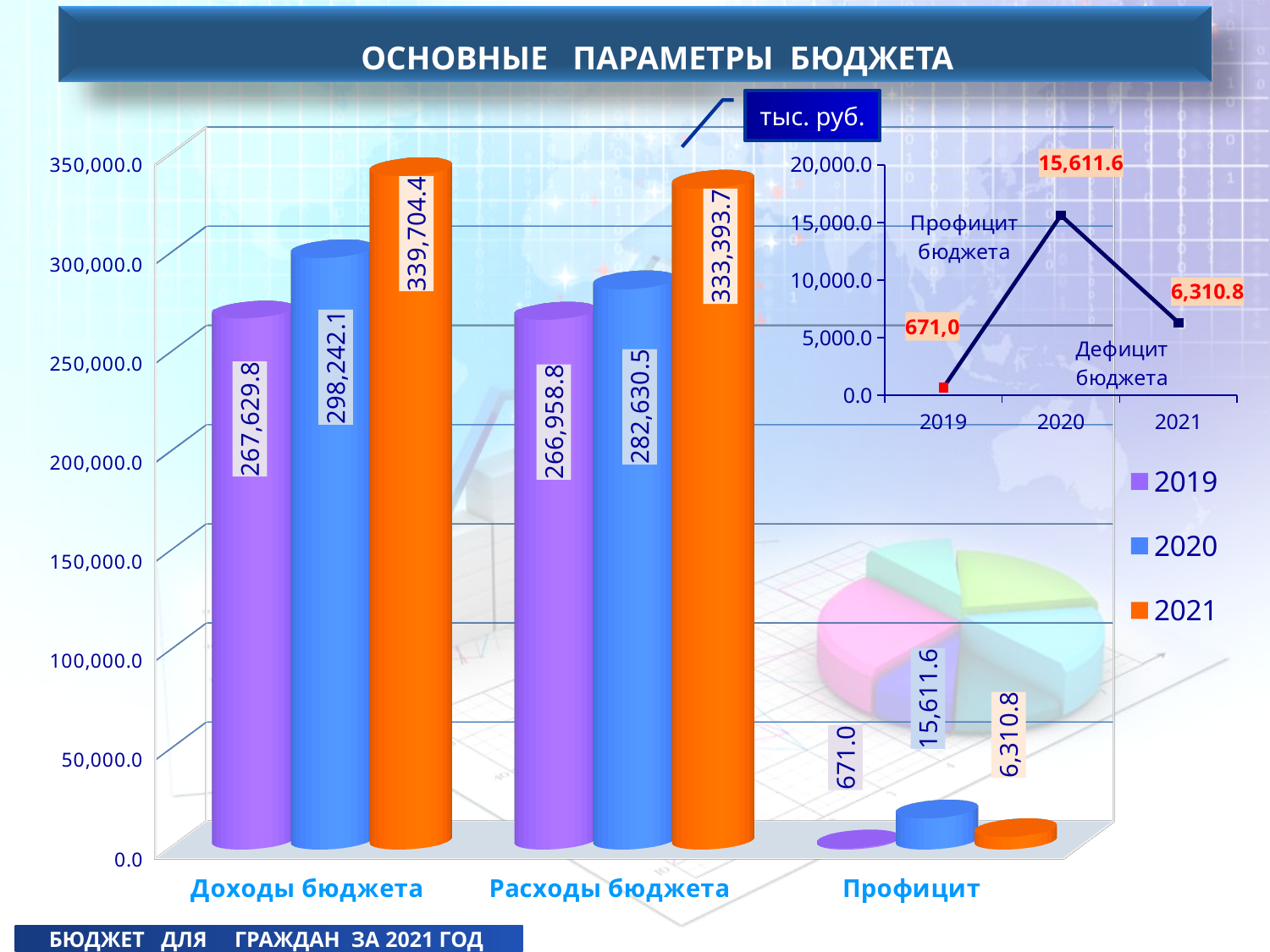
On the bar chart, what is the difference between Доходы бюджета in 2021 and in 2020? 41,462.3 On the bar chart, which is larger: Расходы бюджета in 2020 or Доходы бюджета in 2020? Доходы бюджета in 2020 On the line chart in the top right, what is the difference between the 2020 and 2021 values? 9,300.8 On the line chart in the top right, which year has the highest value? 2020 On the bar chart, what is the value for Расходы бюджета in 2019? 266,958.8 On the bar chart, how many categories are shown on the x axis? 3 On the line chart in the top right, what is the value for 2021? 6,310.8 On the bar chart, what is the value for Доходы бюджета in 2021? 339,704.4 On the bar chart, which year has the highest value for Доходы бюджета? 2021 On the bar chart, how many series does the legend list? 3 On the bar chart, which year has the lowest value for Профицит? 2019 On the bar chart, what is the value for Профицит in 2020? 15,611.6